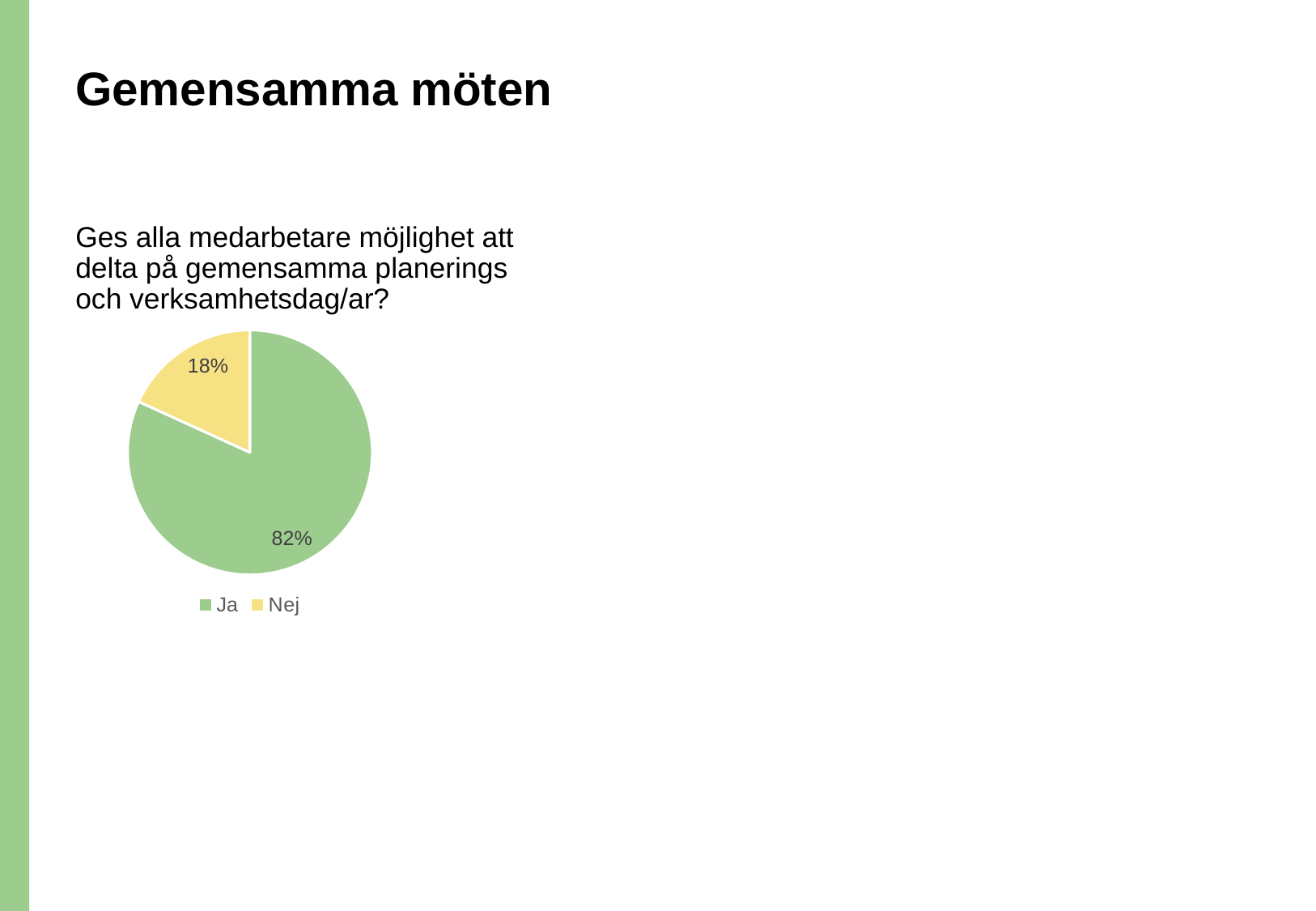
How many categories does the pie chart show? 2 What question does the pie chart answer, according to the text above it? Ges alla medarbetare möjlighet att delta på gemensamma planerings och verksamhetsdag/ar? What colour is the "Nej" slice? yellow Which category has the largest slice of the pie? Ja What share of the pie does "Ja" represent? 82% What share of the pie does "Nej" represent? 18% What kind of chart is shown on the slide? pie chart Which is larger, the "Ja" slice or the "Nej" slice? Ja What is the difference in percentage points between the "Ja" and "Nej" slices? 64 Which category has the smallest slice of the pie? Nej How many entries does the legend list? 2